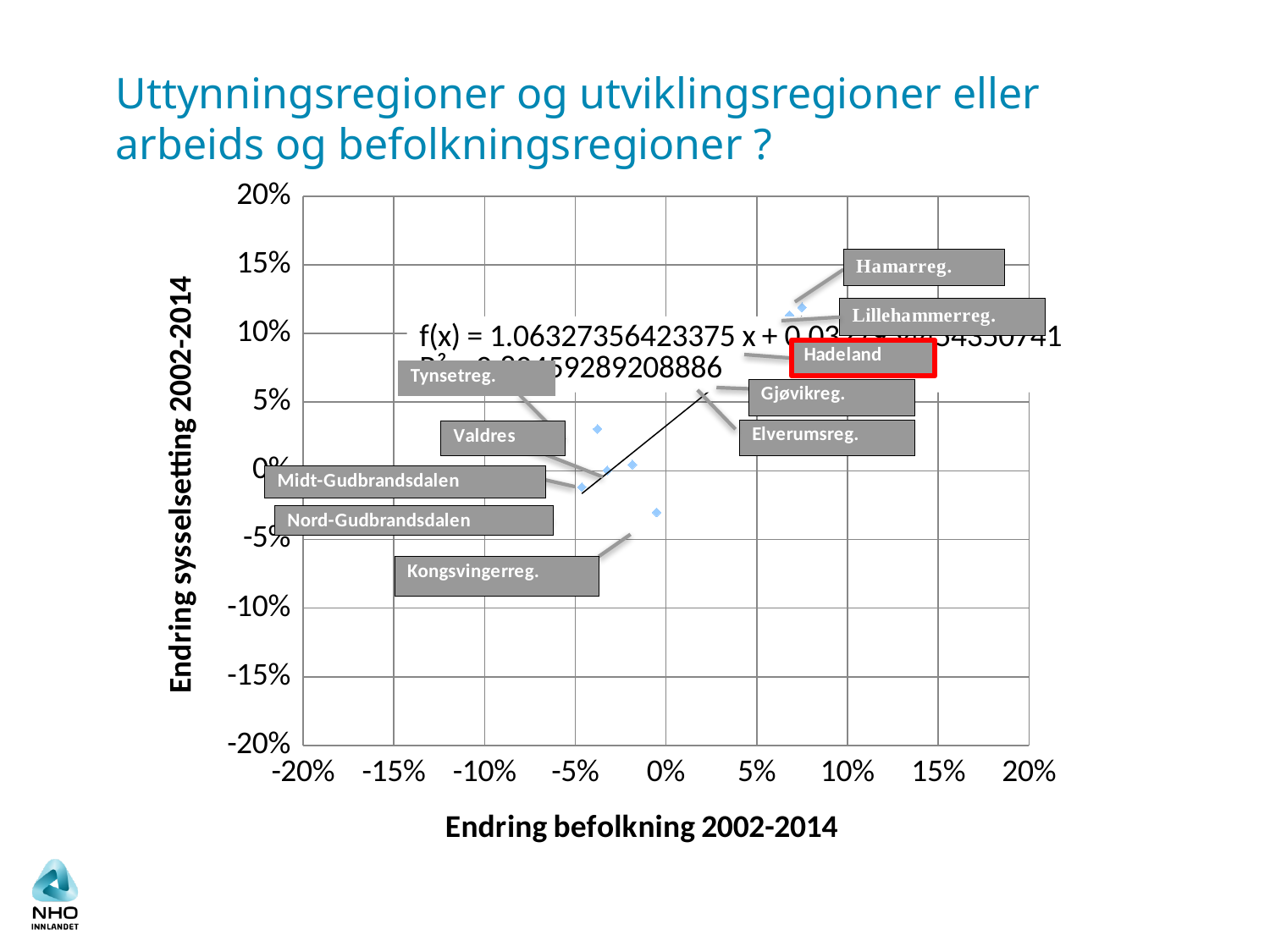
What is the title of the horizontal axis of the chart? Endring befolkning 2002-2014 What kind of chart is shown on the slide? Scatter chart Is the employment change (vertical axis) for Hamarreg. greater or less than 10%? greater Which region's label is highlighted with a red box on the chart? Hadeland Which region has a higher employment change, Hamarreg. or Kongsvingerreg.? Hamarreg. Is the population change (horizontal axis) for Hamarreg. greater or less than 5%? greater Does the trendline on the chart rise or fall as population change increases along the x axis? Rises What is the title of the vertical axis of the chart? Endring sysselsetting 2002-2014 Is the employment change (vertical axis) for Kongsvingerreg. greater or less than 0%? less What is the maximum value shown on the vertical axis of the chart? 20% What is the slope (coefficient of x) in the trendline equation shown on the chart? 1.06327356423375 How many regions are labelled on the chart? 10